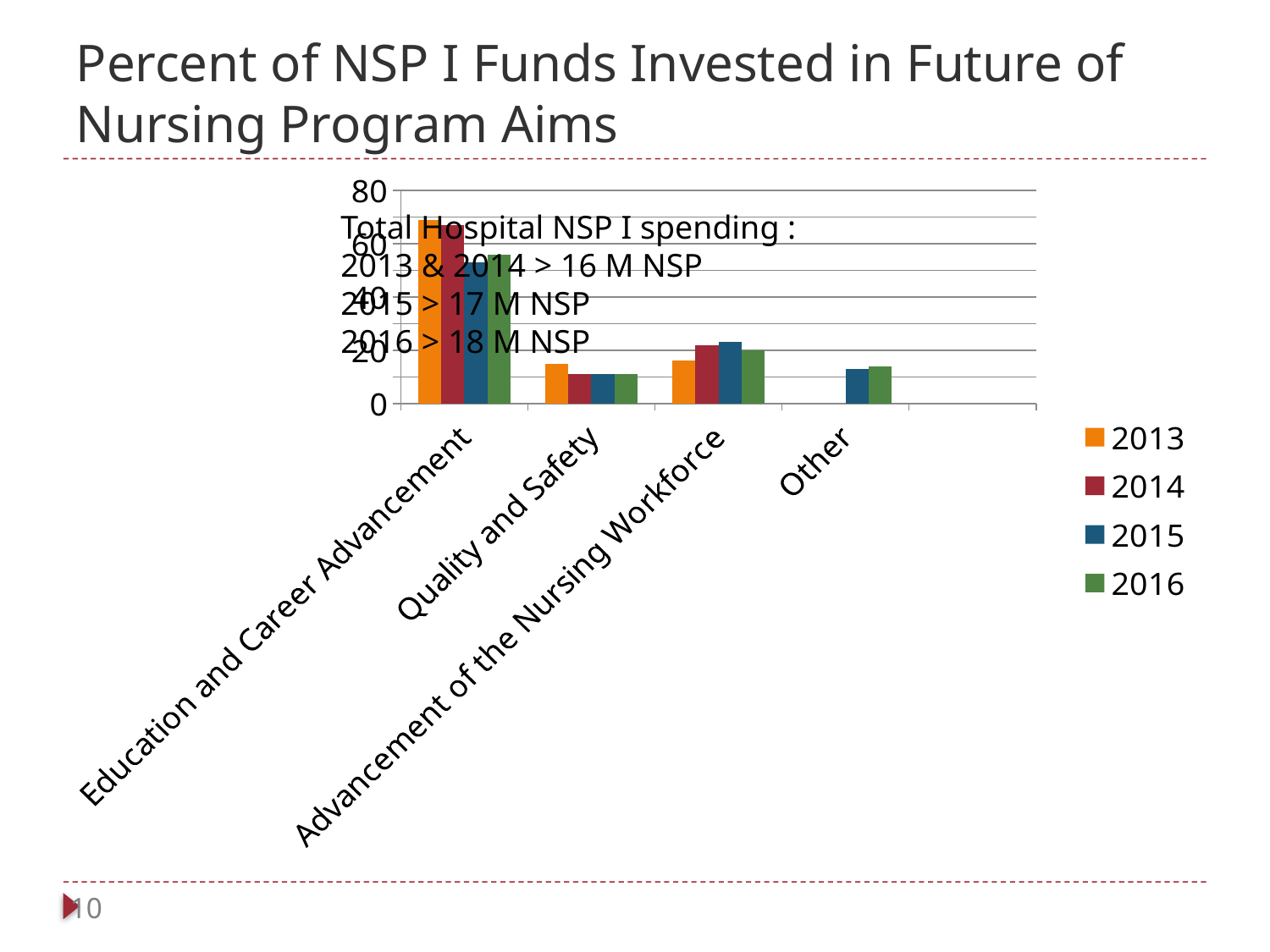
How many categories are shown on the x axis of the chart? 4 Which is larger for Education and Career Advancement, the 2013 value or the 2016 value? 2013 Which category has the highest bars in the chart? Education and Career Advancement Is the value for 2013 in Education and Career Advancement greater or less than 60? greater Is the value for 2016 in Quality and Safety greater or less than 20? less What are the four series listed in the chart legend? 2013, 2014, 2015, 2016 Which is larger for Advancement of the Nursing Workforce, the 2013 value or the 2015 value? 2015 Is the value for 2016 in Other greater or less than 20? less What kind of chart is shown on the slide? bar chart How many series does the chart legend list? 4